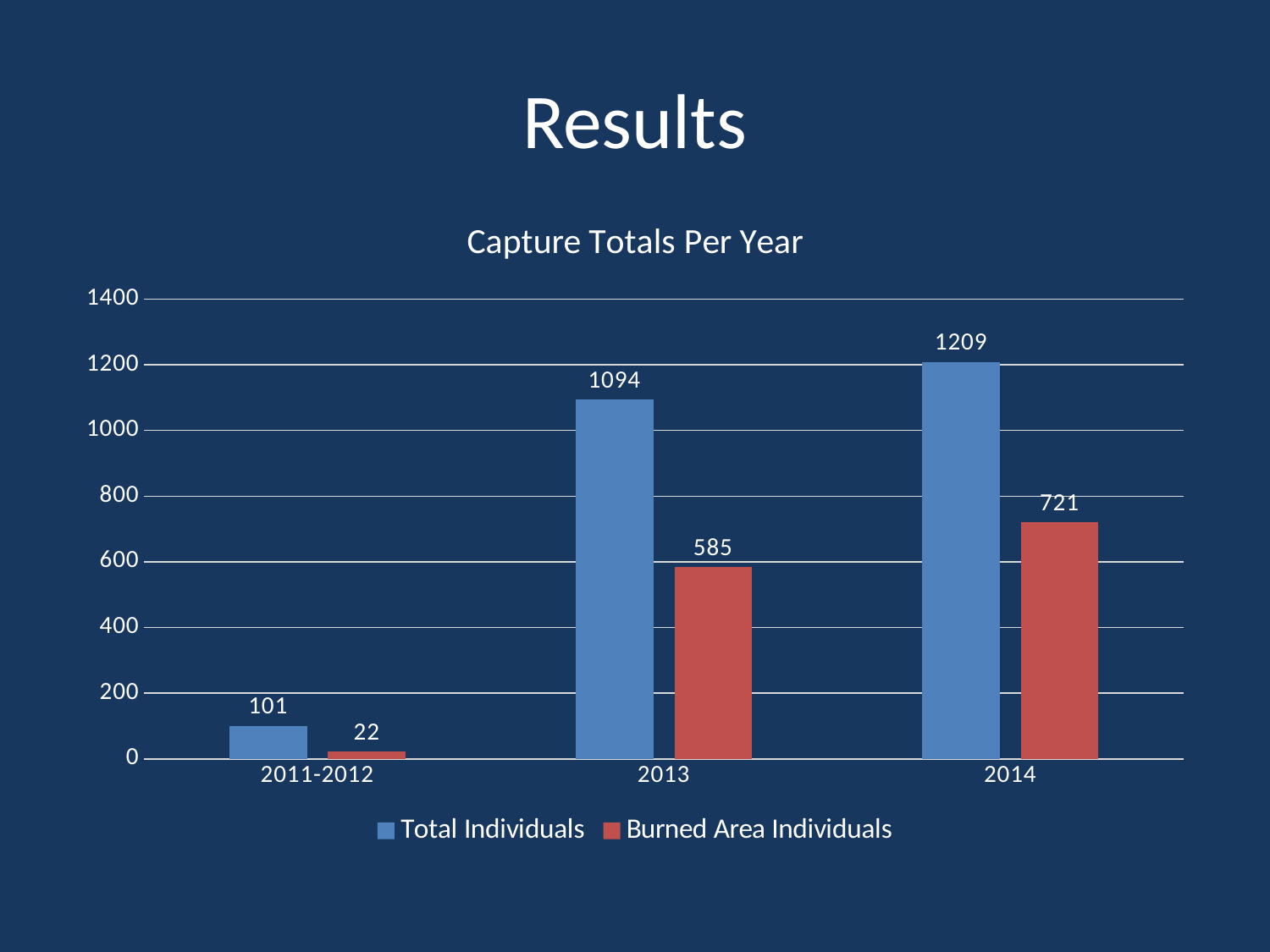
Which is larger: Burned Area Individuals in 2013 or Total Individuals in 2011-2012? Burned Area Individuals in 2013 How many series does the legend list? 2 Which year has the highest value for Total Individuals? 2014 What is the value for Burned Area Individuals in 2011-2012? 22 How many year categories are shown on the x axis? 3 What is the difference between Total Individuals and Burned Area Individuals in 2014? 488 What is the value for Burned Area Individuals in 2014? 721 What is the difference between Total Individuals in 2014 and in 2013? 115 What kind of chart is shown on the slide? Bar chart Which year has the lowest value for Burned Area Individuals? 2011-2012 What is the value for Total Individuals in 2013? 1094 What is the title of the chart? Capture Totals Per Year